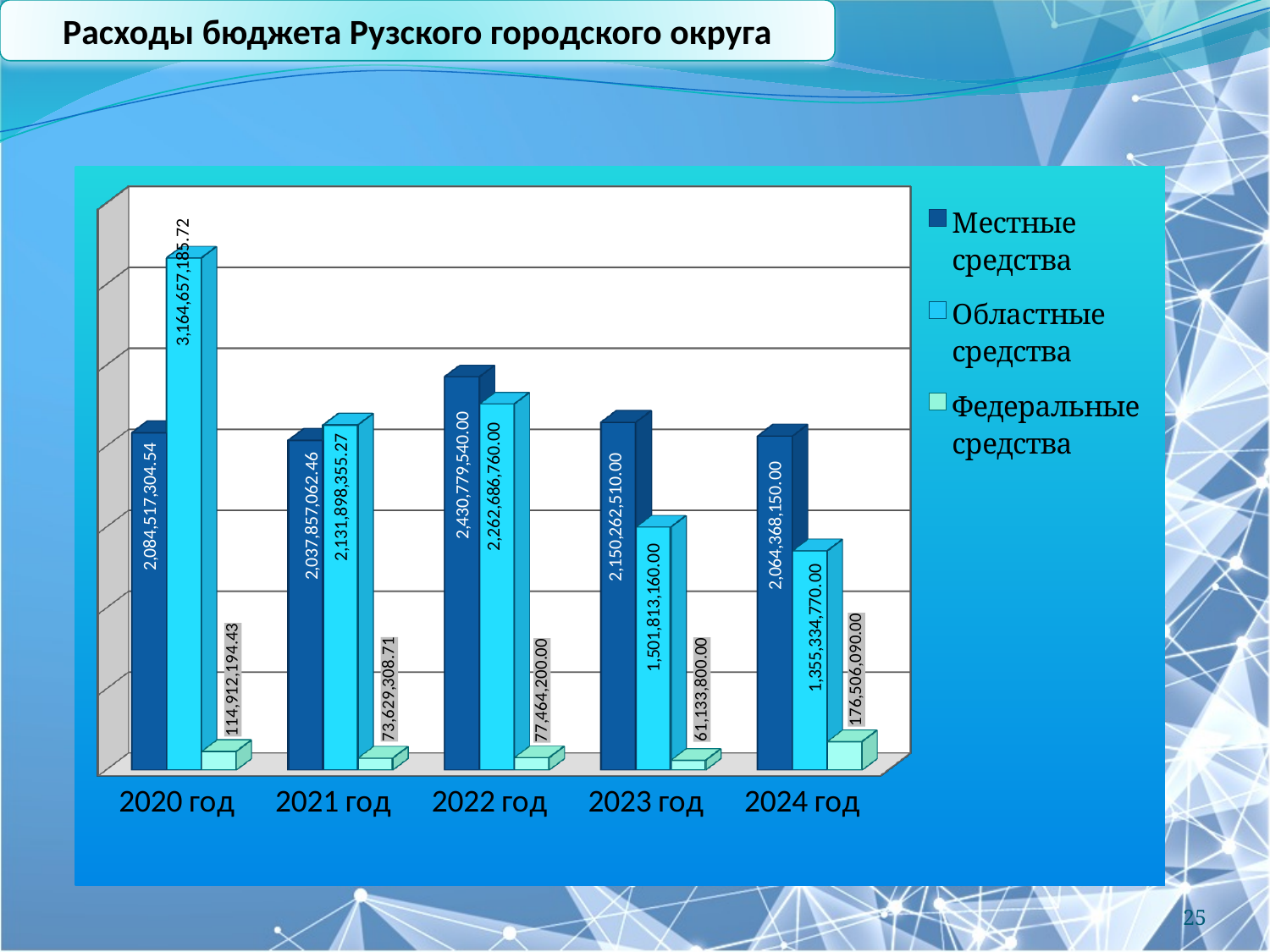
What is the value of Местные средства for 2022 год? 2,430,779,540.00 What kind of chart is shown on the slide? Bar chart What is the value of Областные средства for 2023 год? 1,501,813,160.00 In which year is Местные средства the highest? 2022 год What is the value of Федеральные средства for 2024 год? 176,506,090.00 Which is larger in 2021 год: Местные средства or Областные средства? Областные средства How many series does the legend list? 3 In which year is Федеральные средства the lowest? 2023 год In which year is Областные средства the highest? 2020 год What is the difference between Местные средства and Областные средства in 2023 год? 648,449,350.00 How many years are shown on the x axis? 5 What is the value of Областные средства for 2020 год? 3,164,657,185.72